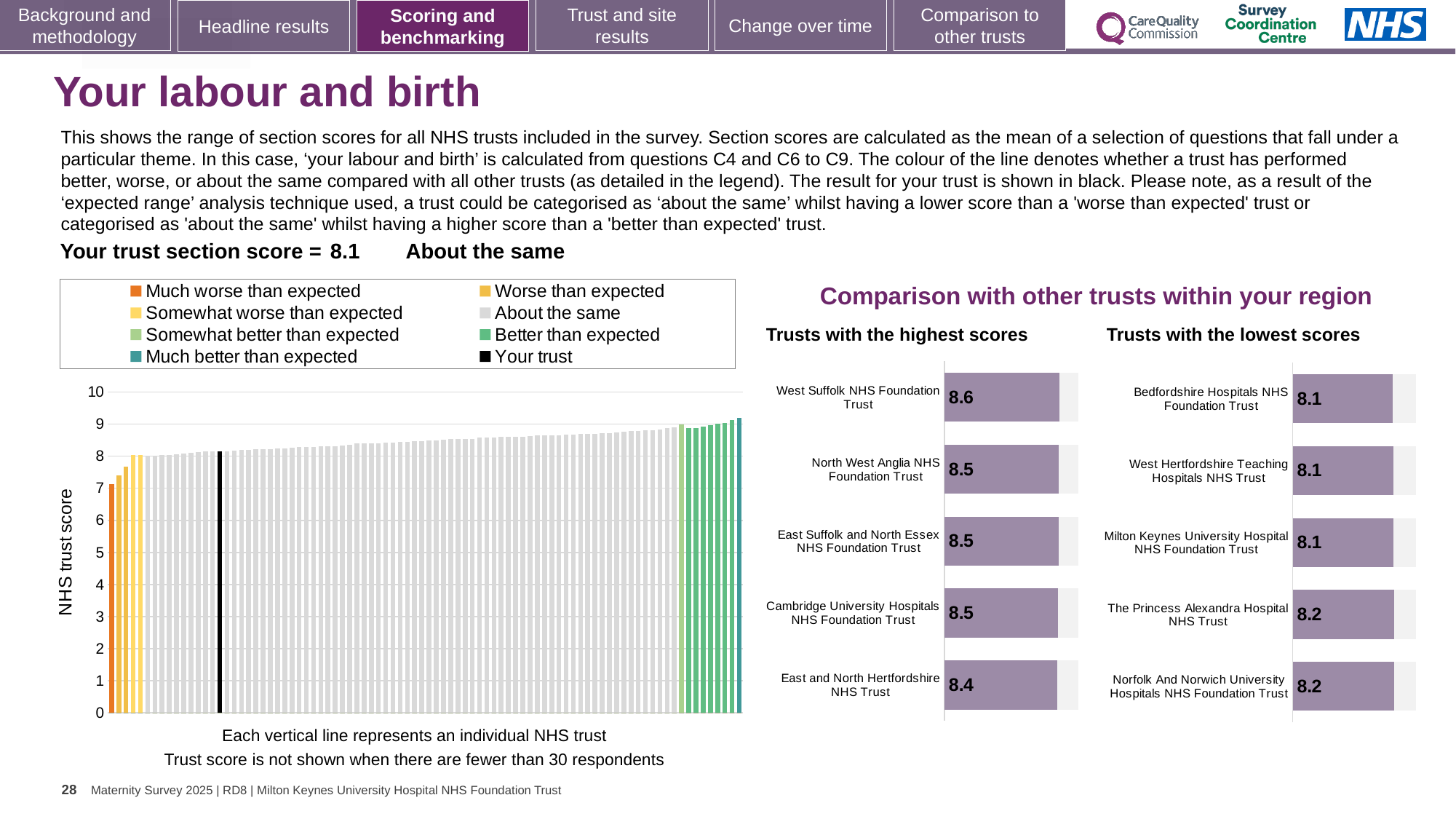
How many trusts are shown in the 'Trusts with the lowest scores' chart? 5 In the 'Trusts with the lowest scores' chart, what is the score for Milton Keynes University Hospital NHS Foundation Trust? 8.1 What is the label on the vertical axis of the left-hand chart? NHS trust score In the 'Trusts with the lowest scores' chart, which has the higher score: Bedfordshire Hospitals NHS Foundation Trust or The Princess Alexandra Hospital NHS Trust? The Princess Alexandra Hospital NHS Trust In the 'Trusts with the highest scores' chart, what is the score for West Suffolk NHS Foundation Trust? 8.6 In the 'Trusts with the highest scores' chart, what is the difference between the scores of West Suffolk NHS Foundation Trust and East and North Hertfordshire NHS Trust? 0.2 How many entries does the legend of the left-hand chart list? 8 What kind of chart is the large chart on the left of the slide? bar chart In the left-hand chart, is the value of the leftmost (orange) bar greater or less than 8? less In the left-hand chart, do the bars rise or fall from left to right? rise In the left-hand chart, is the value of the rightmost bar greater or less than 8? greater In the 'Trusts with the highest scores' chart, which trust has the lowest score? East and North Hertfordshire NHS Trust